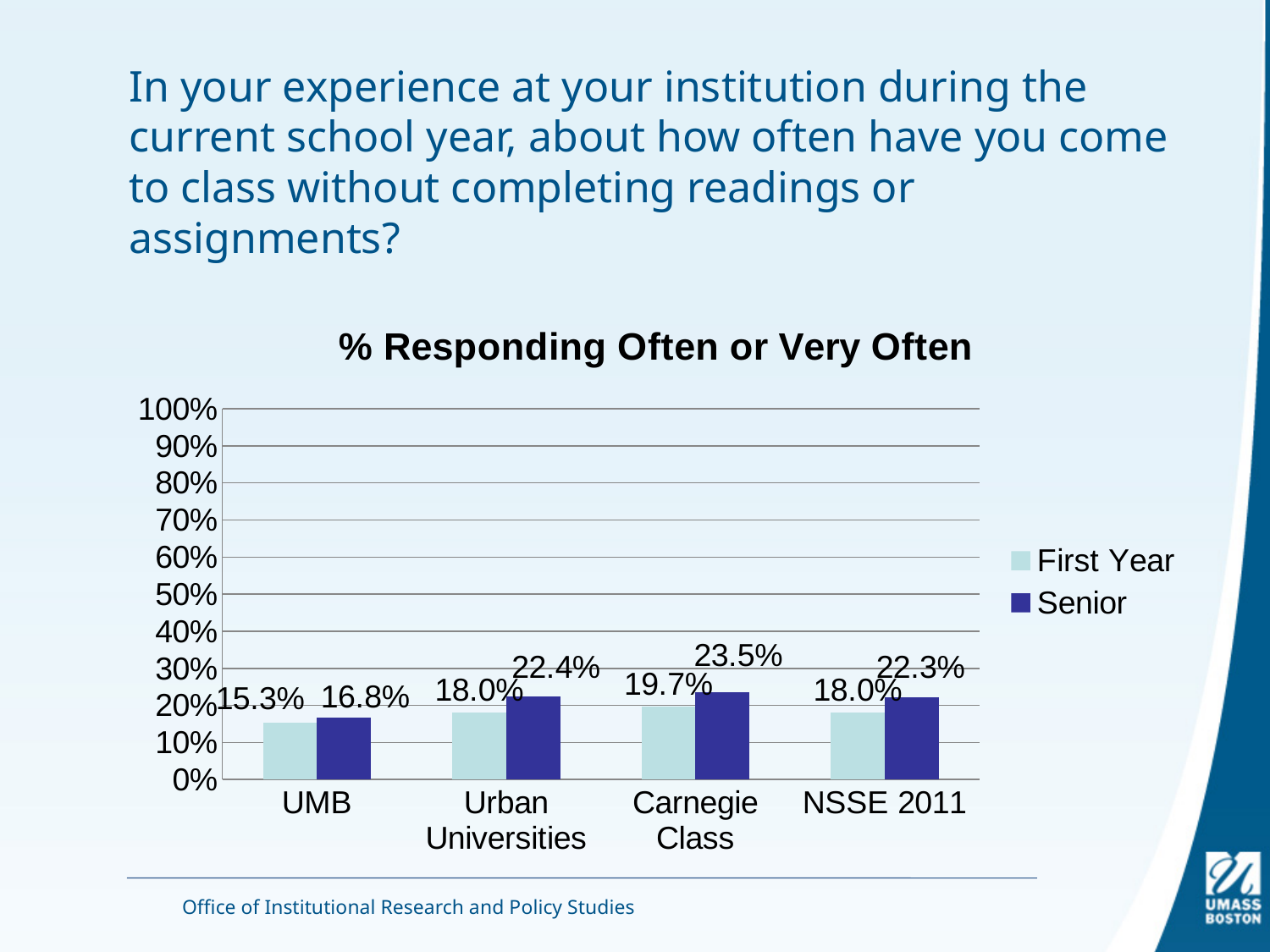
Which is larger, the Senior value for Urban Universities or the Senior value for NSSE 2011? Urban Universities What is the Senior value for Urban Universities? 22.4% Which category has the highest Senior value? Carnegie Class How many categories are shown on the x axis? 4 How many series does the legend list? 2 Which category has the lowest First Year value? UMB What is the Senior value for Carnegie Class? 23.5% What is the First Year value for UMB? 15.3% What is the First Year value for NSSE 2011? 18.0% Is the First Year value for Carnegie Class greater or less than 30%? less What is the difference between the Senior and First Year values for UMB? 1.5% What type of chart is shown? bar chart